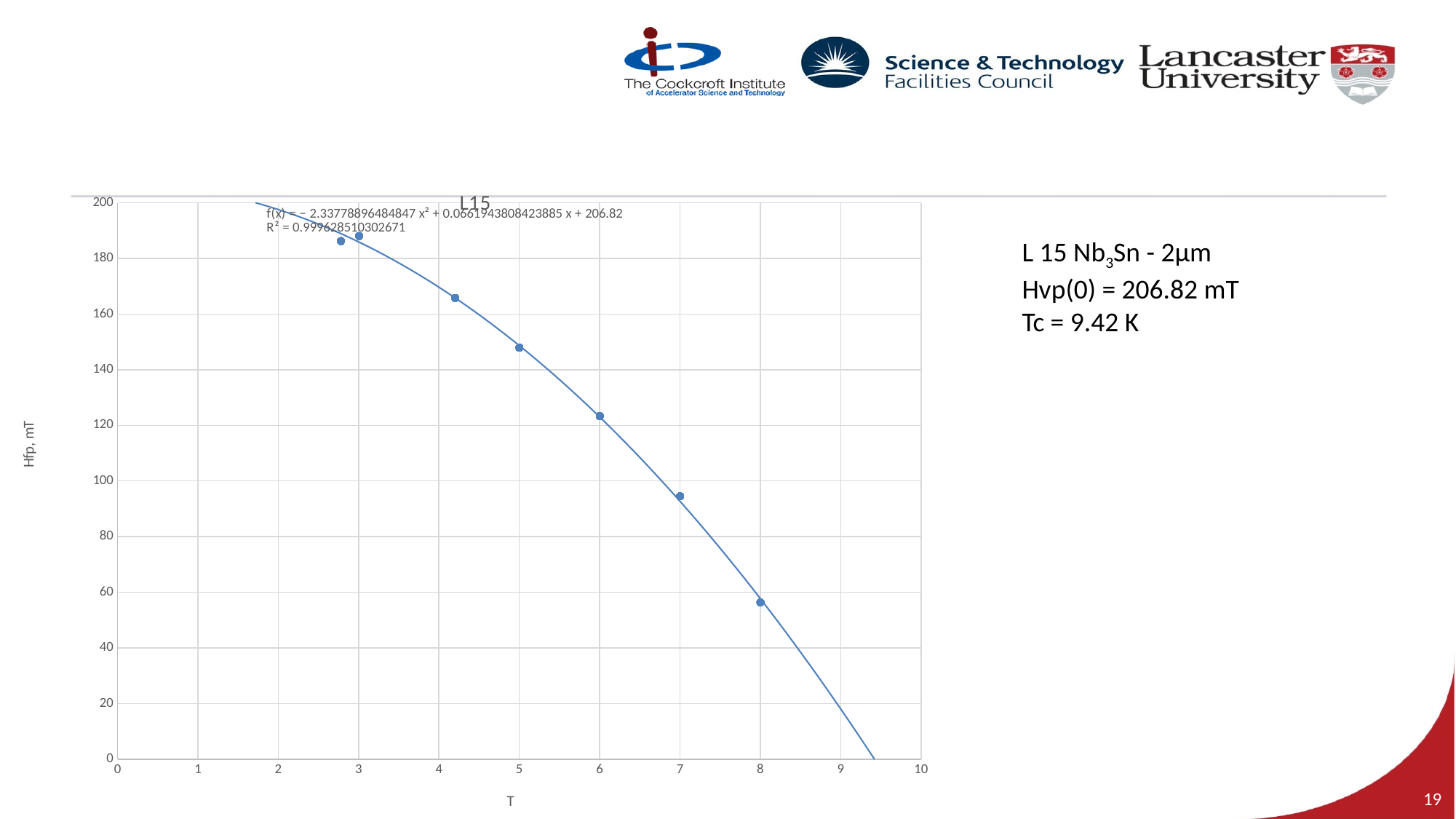
Do the plotted values rise or fall as T increases along the x axis? fall What is the label of the y axis of the chart? Hfp, mT Is the value for the point at T = 3 greater or less than 180? greater What is the title of the chart? L15 How many data points are plotted on the chart? 7 Is the value for the point at T = 8 greater or less than 80? less Is the value for the point at T = 5 greater or less than 140? greater At which T value is the lowest plotted Hfp point? 8 What kind of chart is shown on the slide? scatter chart Which has the larger Hfp value, the point at T = 5 or the point at T = 7? T = 5